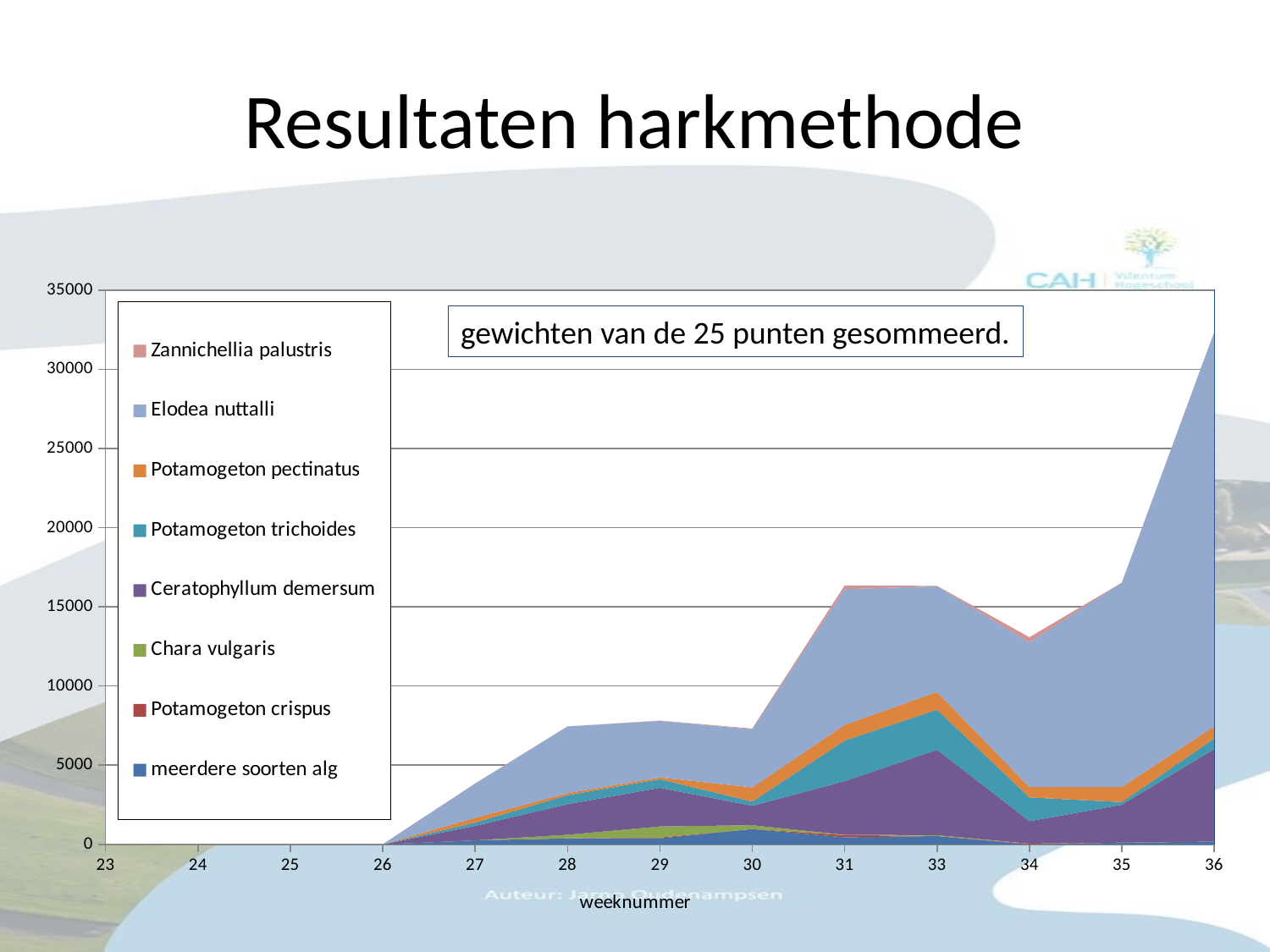
Is the total stacked value at week 31 greater or less than 15000? greater Which is larger, the total stacked value at week 31 or at week 34? week 31 How many series does the legend list? 8 Does the total stacked value rise or fall from week 34 to week 36? rise At which week number is the total stacked value highest? 36 Is the total stacked value at week 36 greater or less than 30000? greater Is the total stacked value at week 28 greater or less than 10000? less How many week numbers are marked on the x axis? 13 Which series is listed first (at the top) in the legend? Zannichellia palustris What is the label of the x axis? weeknummer What kind of chart is shown on the slide? area chart